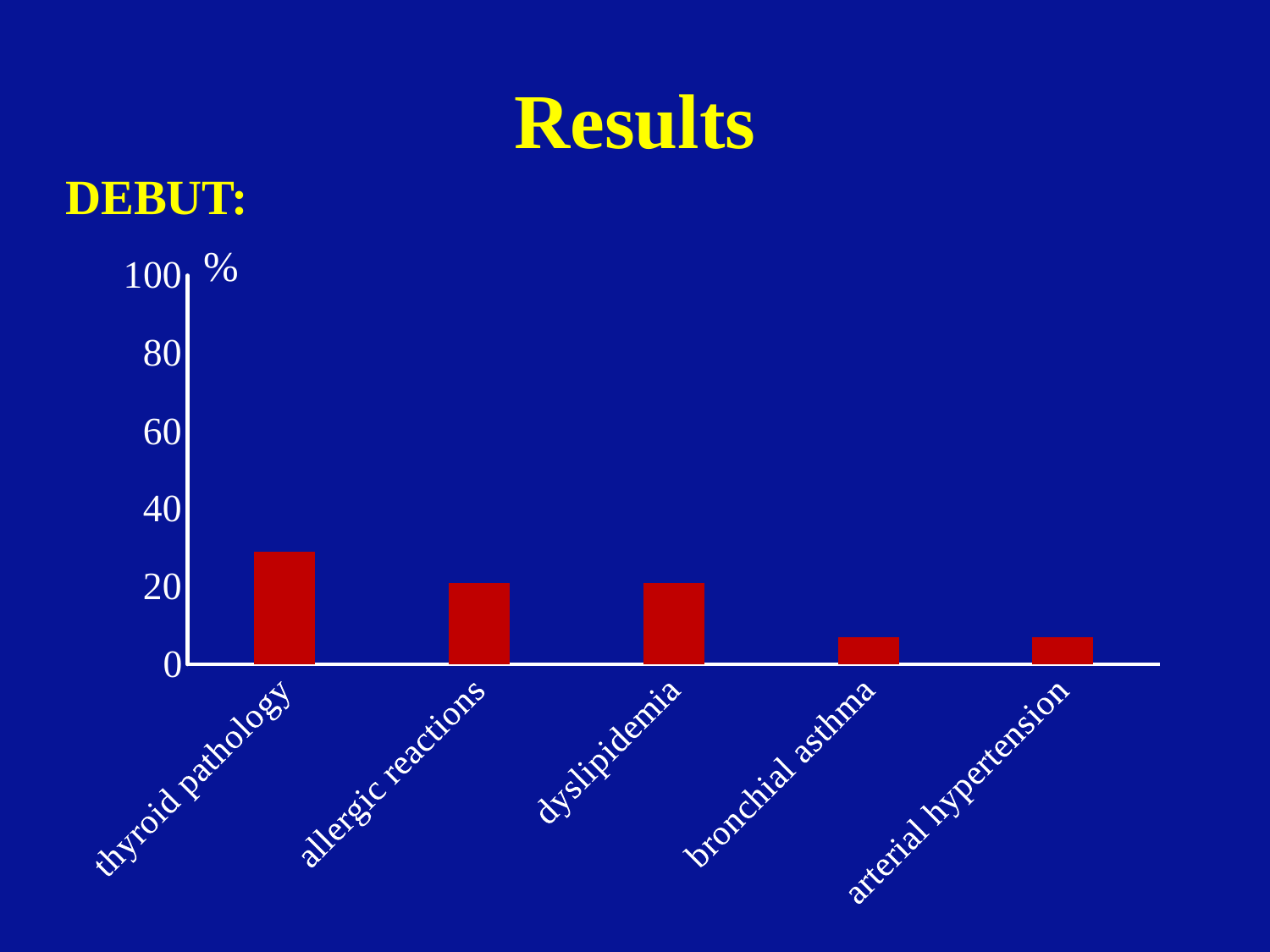
Which category has the highest value in the chart? thyroid pathology How many categories are plotted in the chart? 5 Is the value for thyroid pathology greater or less than 20? greater Which is larger, the value for thyroid pathology or the value for allergic reactions? thyroid pathology What kind of chart is shown on the slide? bar chart Is the value for arterial hypertension greater or less than 20? less Which is larger, the value for dyslipidemia or the value for bronchial asthma? dyslipidemia Is the value for bronchial asthma greater or less than 20? less What unit is shown at the top of the vertical axis? % Do the values generally rise or fall from left to right across the categories? fall